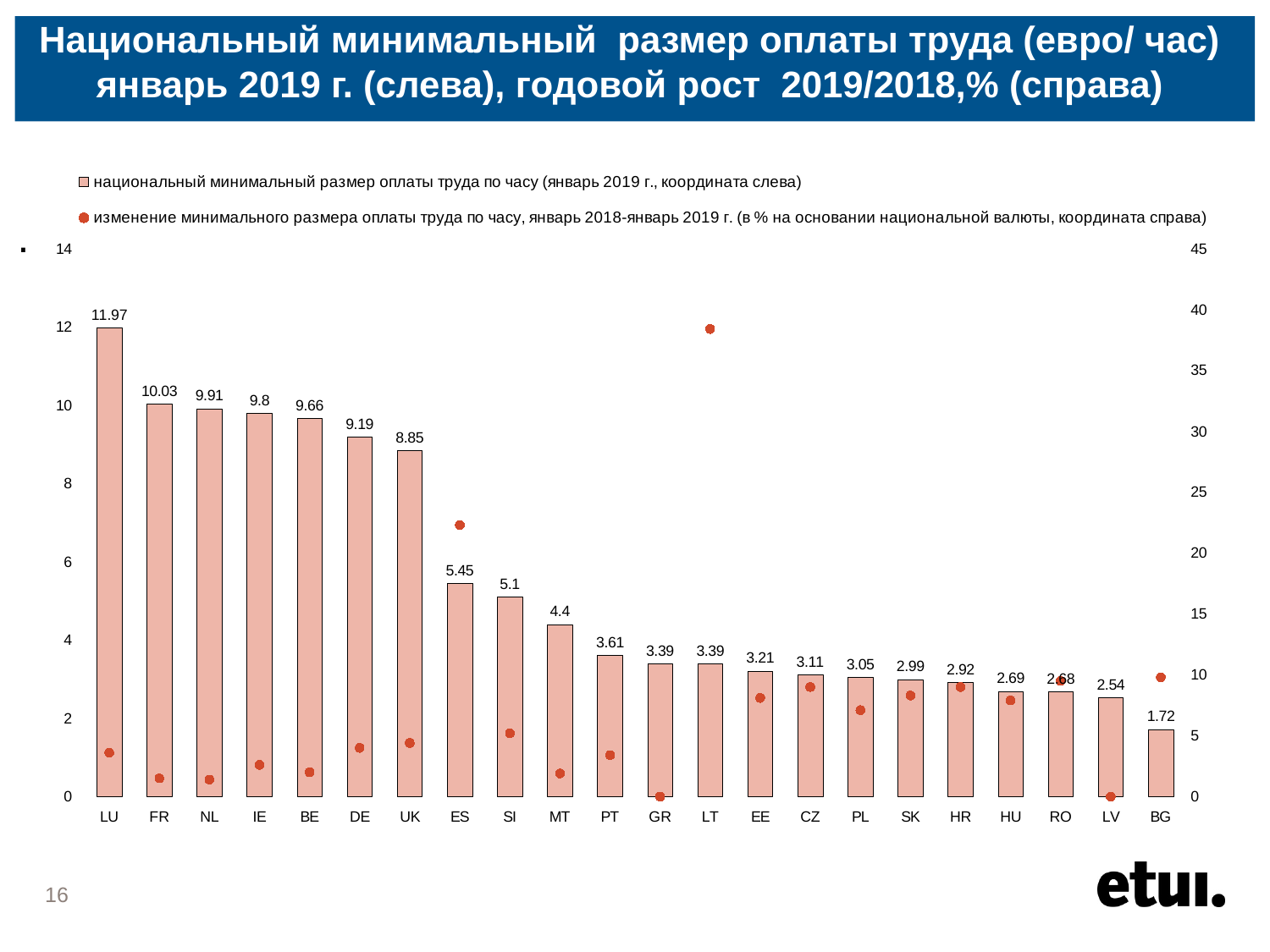
How many countries are shown on the x axis of the chart? 22 Which has a higher minimum hourly wage, UK or ES? UK How many series does the legend list? 2 Do the minimum hourly wage bars rise or fall from left to right along the x axis? fall What is the national minimum hourly wage (euro/hour) shown for ES? 5.45 Is the annual growth value (right axis) for LU greater or less than 5? less Which country has the lowest national minimum hourly wage in the chart? BG What is the difference between the minimum hourly wage of FR and that of DE? 0.84 What kind of chart is used to show the national minimum hourly wage series? bar chart Which country has the highest national minimum hourly wage in the chart? LU What is the national minimum hourly wage (euro/hour) shown for LU? 11.97 Is the annual growth value (right axis) for LT greater or less than 35? greater